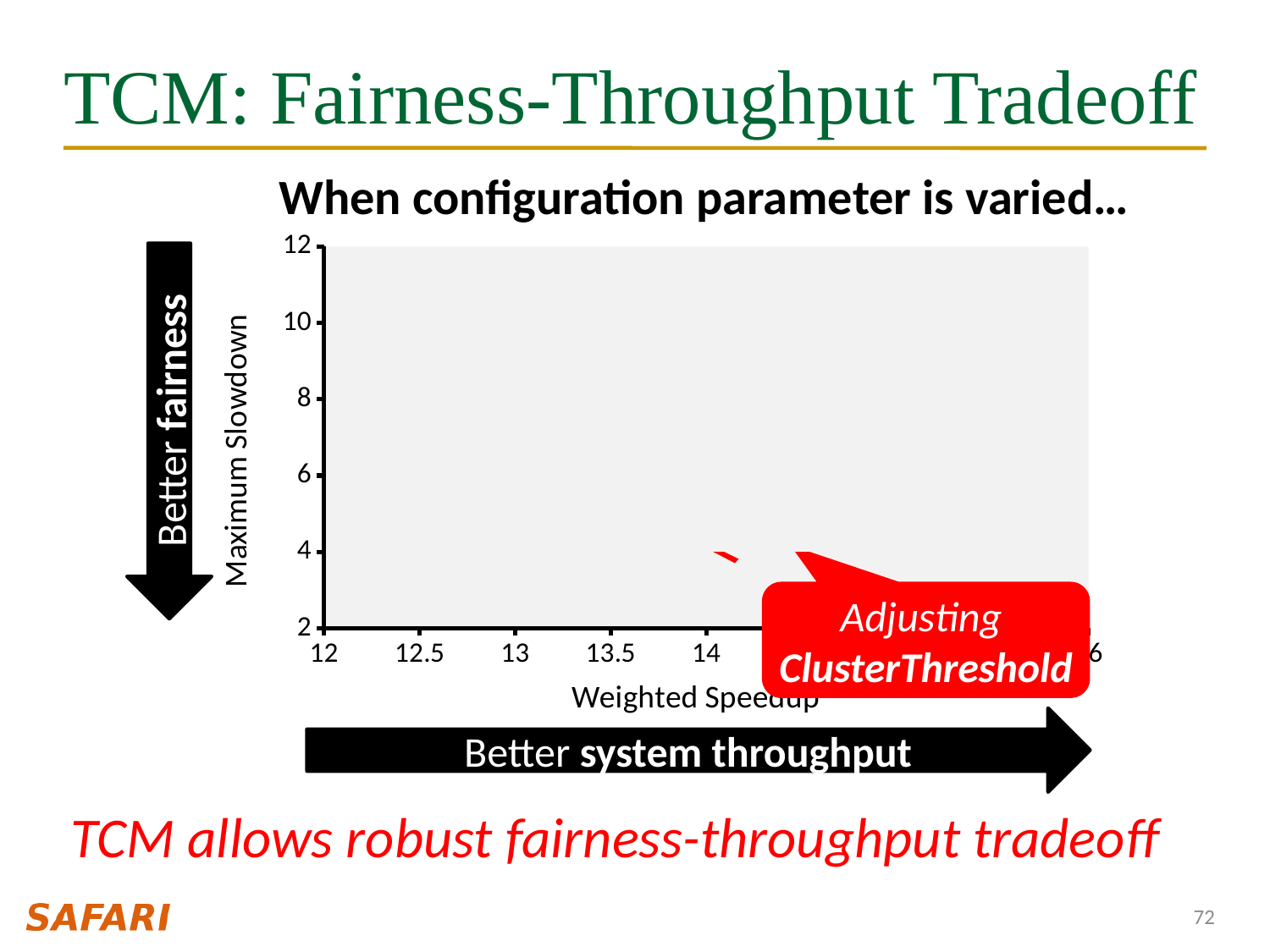
What kind of chart is shown on the slide? scatter chart How many tick labels are shown on the vertical axis of the chart? 6 What is the lowest tick value shown on the vertical axis of the chart? 2 What is the highest tick value shown on the vertical axis of the chart? 12 What is the label of the chart's vertical axis? Maximum Slowdown What is the leftmost tick value shown on the horizontal axis of the chart? 12 What is the title shown above the chart? When configuration parameter is varied…